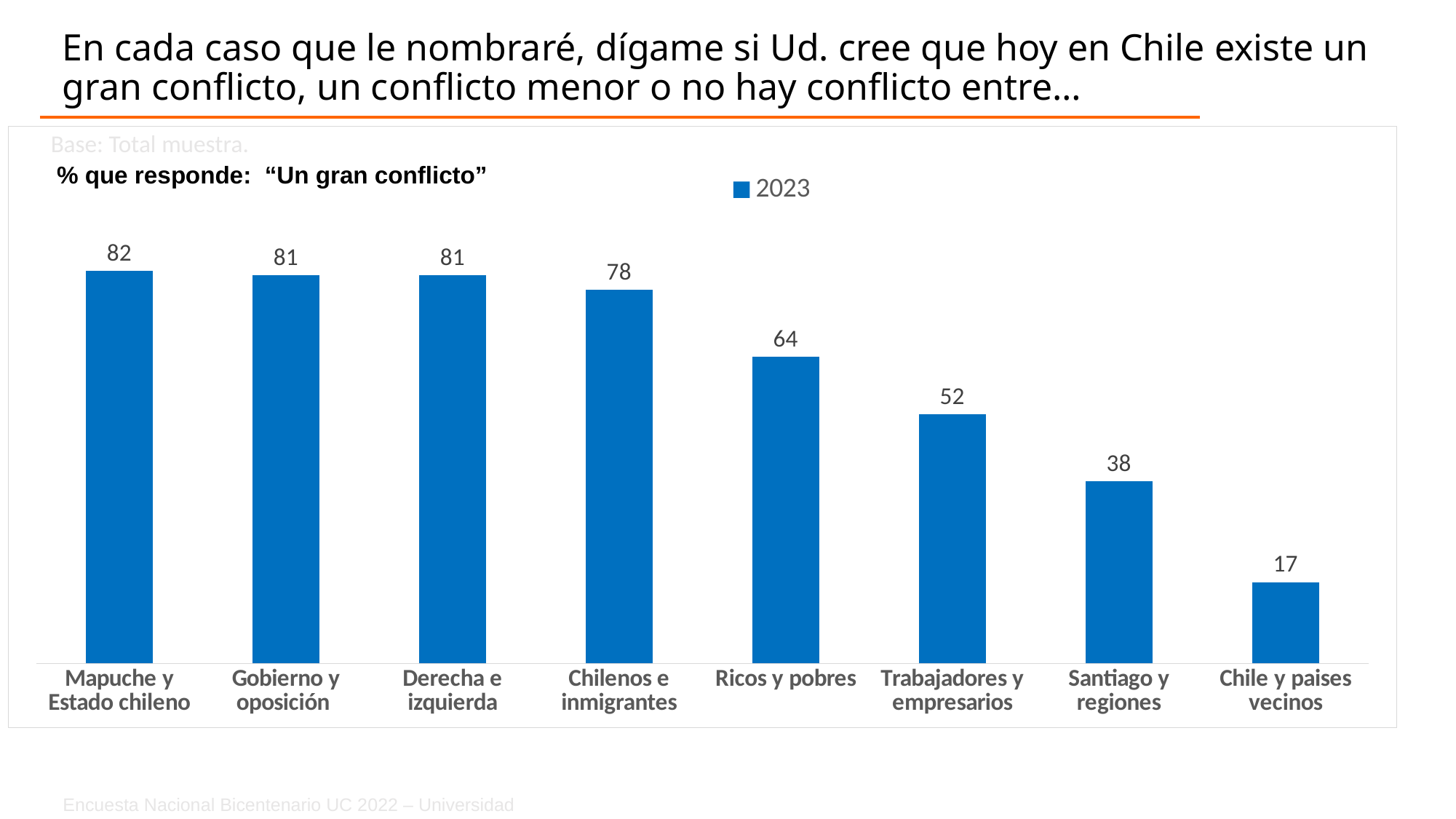
What is the value for Chile y paises vecinos? 17 Which category has the lowest value? Chile y paises vecinos What is the value for Santiago y regiones? 38 What year does the legend entry show? 2023 How many categories are shown on the chart? 8 What is the difference between the values for Chilenos e inmigrantes and Trabajadores y empresarios? 26 Which is larger, the value for Ricos y pobres or the value for Santiago y regiones? Ricos y pobres What kind of chart is shown on the slide? Bar chart What is the value for Ricos y pobres? 64 Which category has the highest value? Mapuche y Estado chileno How many series does the legend list? 1 What is the value for Mapuche y Estado chileno? 82